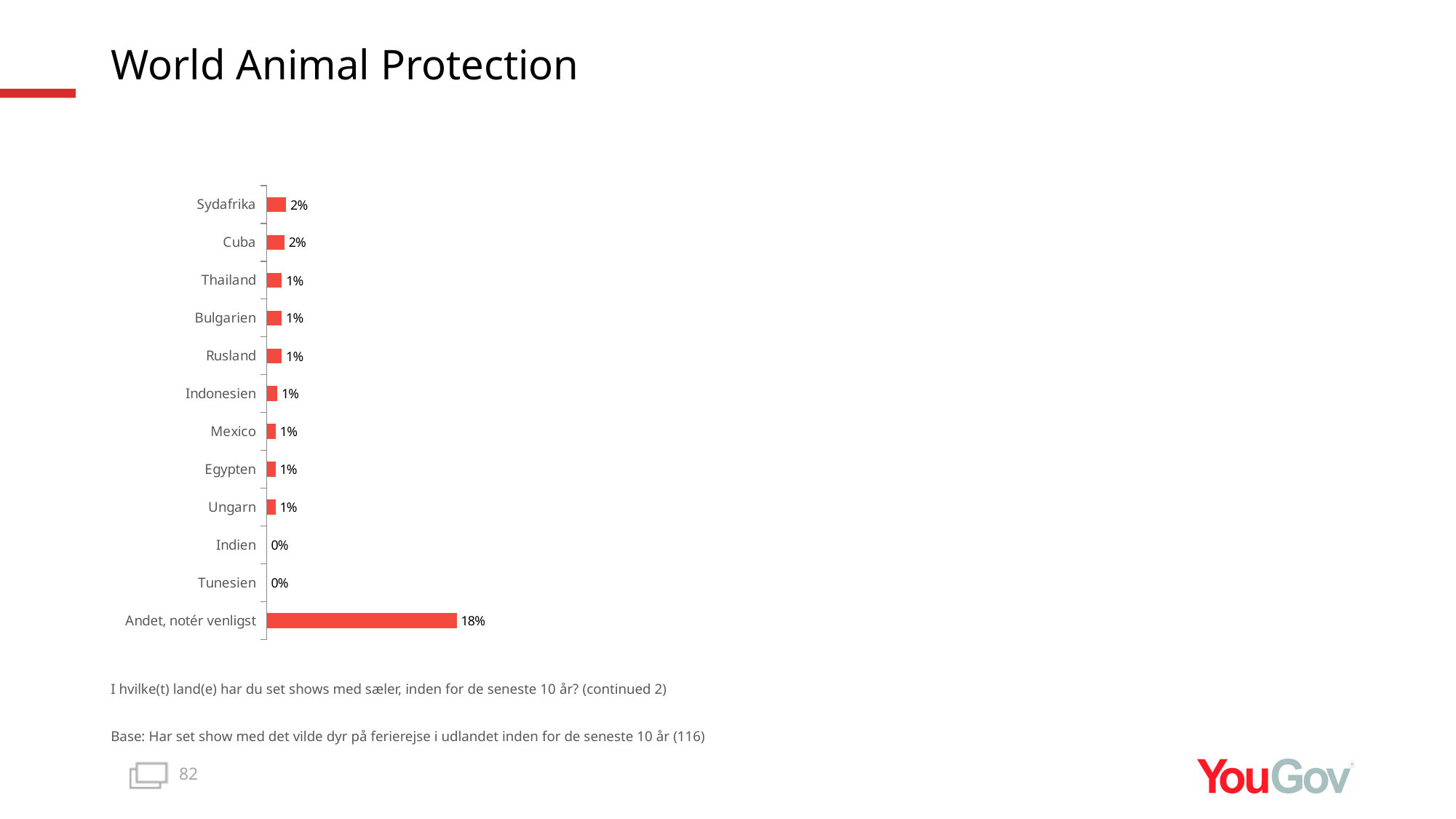
What is the value for Andet, notér venligst? 18% What kind of chart is shown on the slide? Bar chart What is the difference between the values for Sydafrika and Rusland? 1% Which category has the highest value? Andet, notér venligst What is the value for Tunesien? 0% What colour are the bars in the chart? Red What is the value for Indien? 0% What is the value for Sydafrika? 2% Which is larger, the value for Cuba or the value for Bulgarien? Cuba What is the value for Thailand? 1% How many categories are shown in the chart? 12 What is the difference between the values for Andet, notér venligst and Cuba? 16%